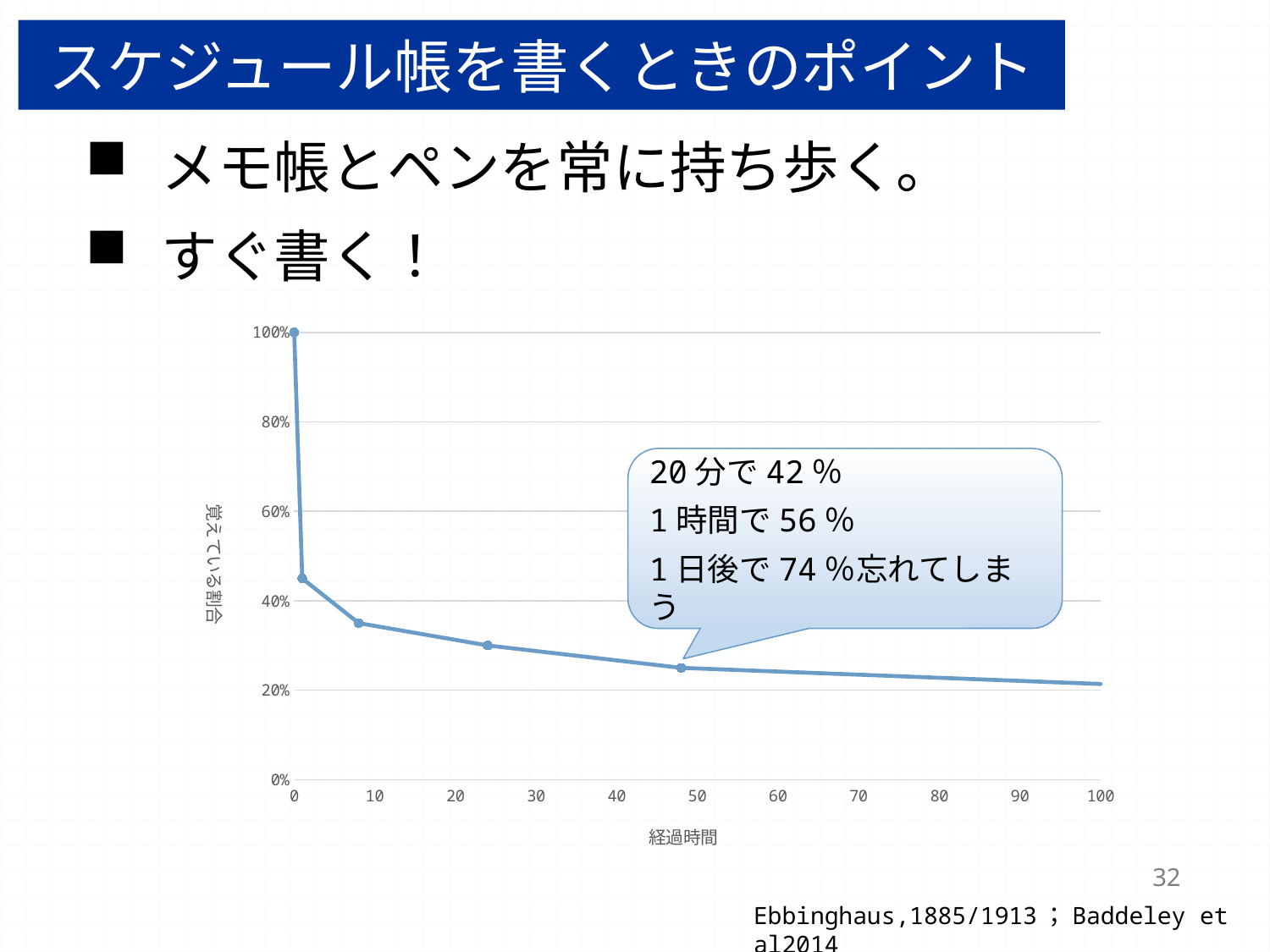
What is the label of the x axis of the chart? 経過時間 Do the values rise or fall as elapsed time (経過時間) increases along the x axis? fall What is the label of the y axis of the chart? 覚えている割合 Which is larger, the value at elapsed time 10 or the value at elapsed time 50? elapsed time 10 What kind of chart is shown on the slide? line chart At which elapsed time is the plotted value highest? 0 Is the value at elapsed time 10 greater or less than 40%? less Is the value at elapsed time 20 greater or less than 20%? greater Is the value at elapsed time 50 greater or less than 40%? less What is the value of 覚えている割合 at elapsed time 0? 100%